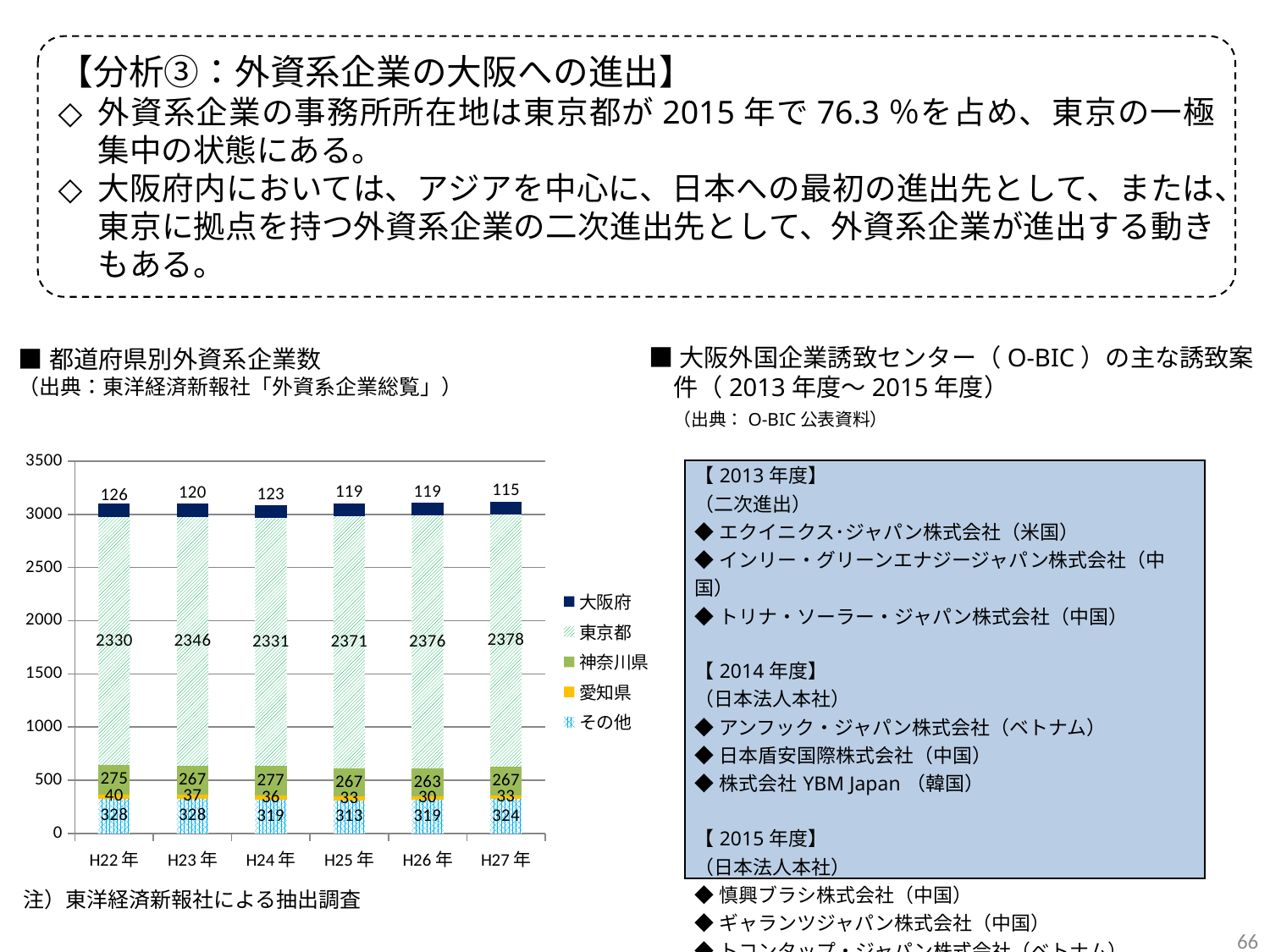
Which is larger, the その他 value in H22年 or in H25年? H22年 What is the total of the stacked bar for H22年? 3099 What is the value for 神奈川県 in H24年? 277 What is the value for 大阪府 in H22年? 126 What kind of chart is shown on the slide? stacked bar chart What is the difference between the 東京都 values in H27年 and H22年? 48 In which year is the value for 大阪府 the highest? H22年 How many series does the legend of the chart list? 5 In which year is the value for 東京都 the lowest? H22年 How many years (categories) are shown on the x axis of the chart? 6 What is the value for 愛知県 in H26年? 30 What is the value for 東京都 in H27年? 2378